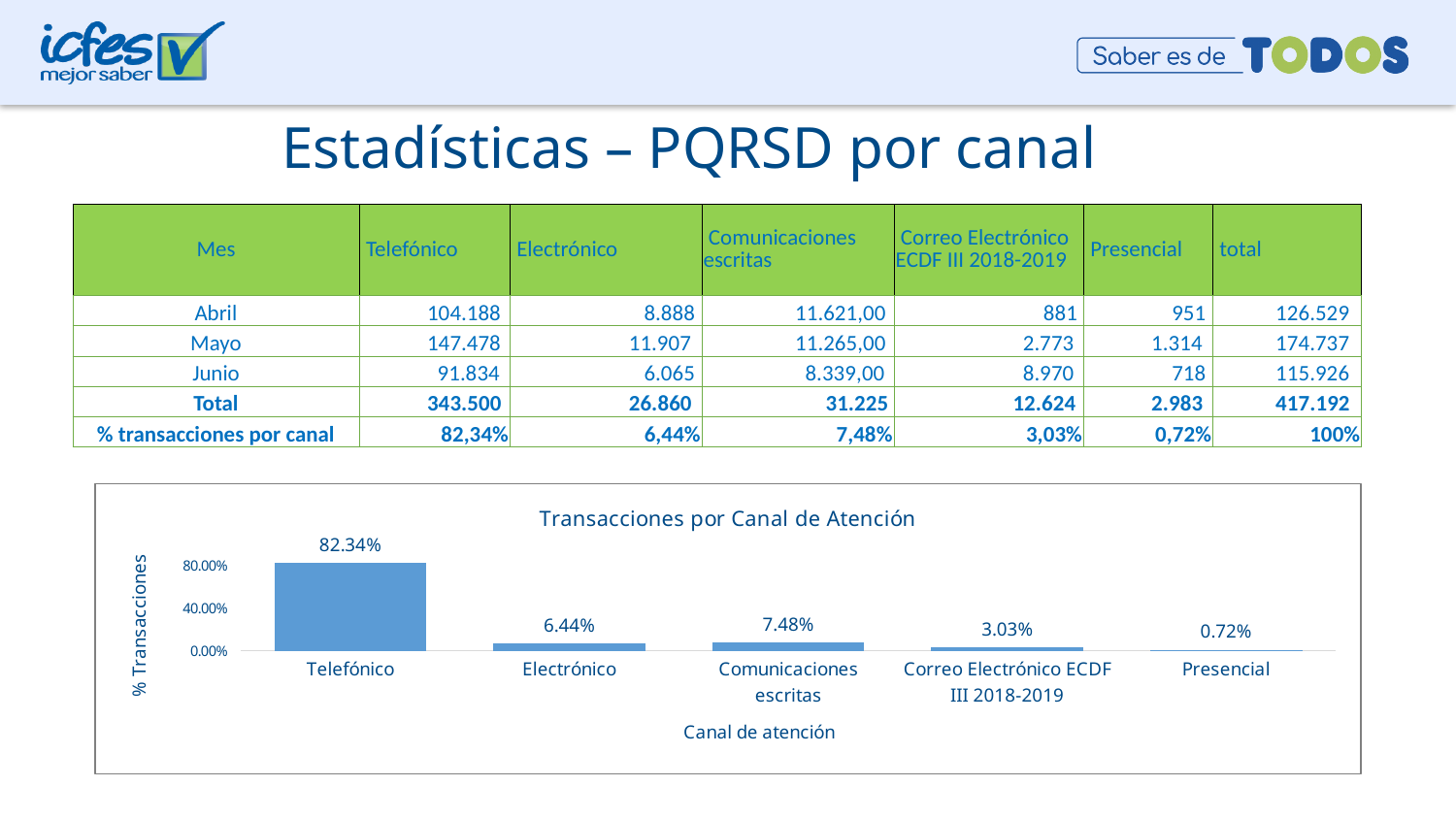
Which category has the lowest value in the chart? Presencial Which category has the highest value in the chart? Telefónico What is the title of the chart? Transacciones por Canal de Atención What is the value for Comunicaciones escritas in the chart? 7.48% What type of chart is shown on the slide? bar chart What is the difference between the values for Comunicaciones escritas and Electrónico? 1.04% What is the value for Correo Electrónico ECDF III 2018-2019 in the chart? 3.03% What is the value for Telefónico in the chart? 82.34% Which is larger, the value for Electrónico or the value for Correo Electrónico ECDF III 2018-2019? Electrónico How many categories are plotted in the chart? 5 What is the value for Electrónico in the chart? 6.44% What is the label of the x axis in the chart? Canal de atención